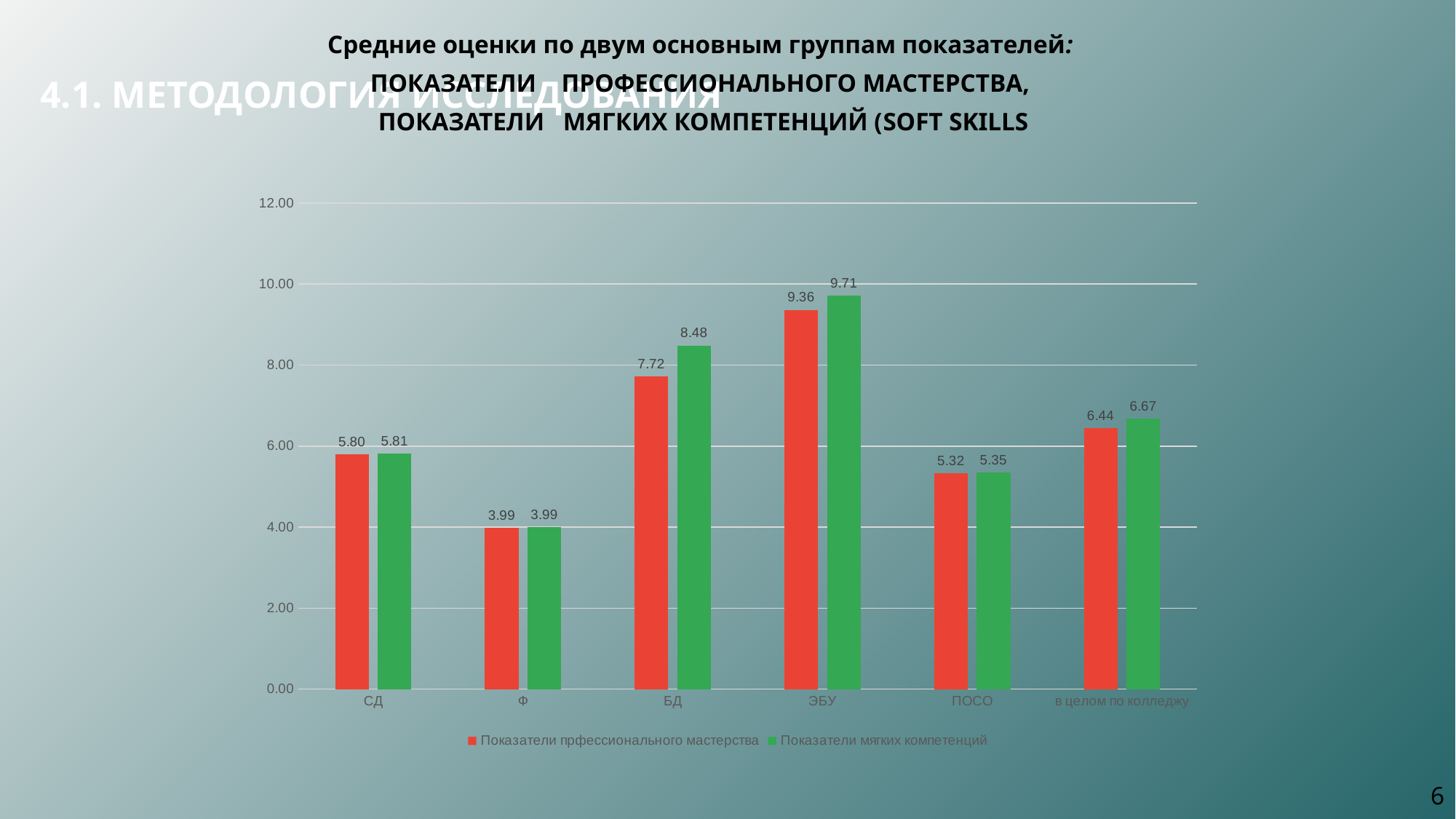
What is the value of Показатели прфессионального мастерства for в целом по колледжу? 6.44 What kind of chart is shown on the slide? bar chart Is the value of Показатели мягких компетенций for ПОСО greater or less than 6.00? less What is the value of Показатели мягких компетенций for БД? 8.48 What colour are the bars for Показатели мягких компетенций? green How many categories are shown on the x axis? 6 What is the difference between Показатели мягких компетенций and Показатели прфессионального мастерства for БД? 0.76 Which category has the highest value for Показатели мягких компетенций? ЭБУ What is the value of Показатели прфессионального мастерства for ЭБУ? 9.36 Which is larger for ЭБУ: Показатели прфессионального мастерства or Показатели мягких компетенций? Показатели мягких компетенций Which category has the lowest value for Показатели прфессионального мастерства? Ф How many series does the legend list? 2